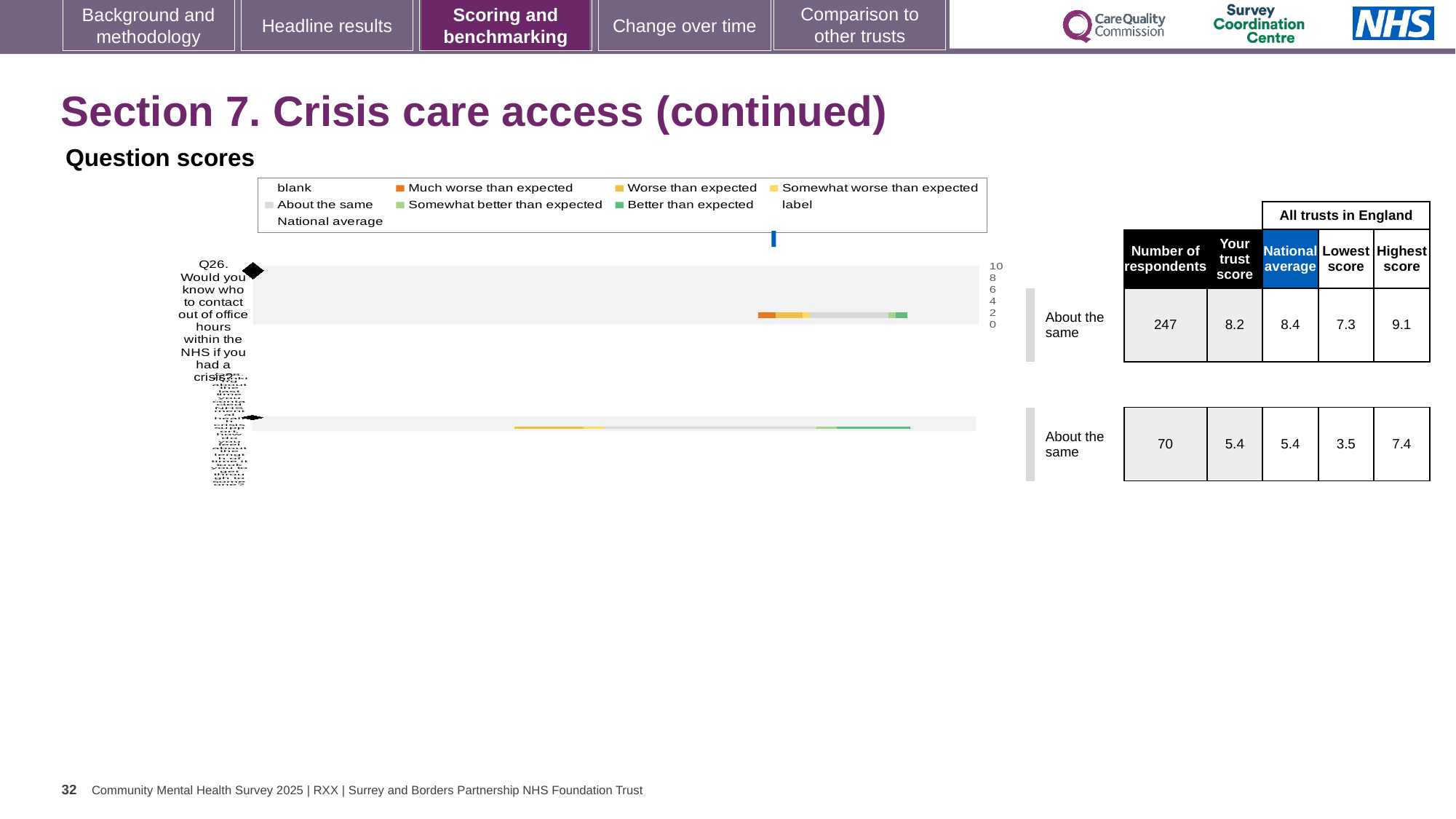
What is the national average score for Q26? 8.4 What is the highest score among all trusts in England for Q26? 9.1 For Q26, which is larger: the trust's score or the national average? National average What is the trust's score for Q26 (Would you know who to contact out of office hours within the NHS if you had a crisis?)? 8.2 In the second row of the table, how many respondents are listed? 70 Which benchmark category is the trust's Q26 score placed in? About the same What is the lowest score among all trusts in England for Q26? 7.3 For Q26, what is the difference between the highest and lowest trust scores in England? 1.8 What colour in the legend represents 'Much worse than expected'? Orange How many respondents answered Q26? 247 For Q26, how much higher is the national average than the trust's score? 0.2 What kind of chart is used to show the question scores on this slide? Bar chart